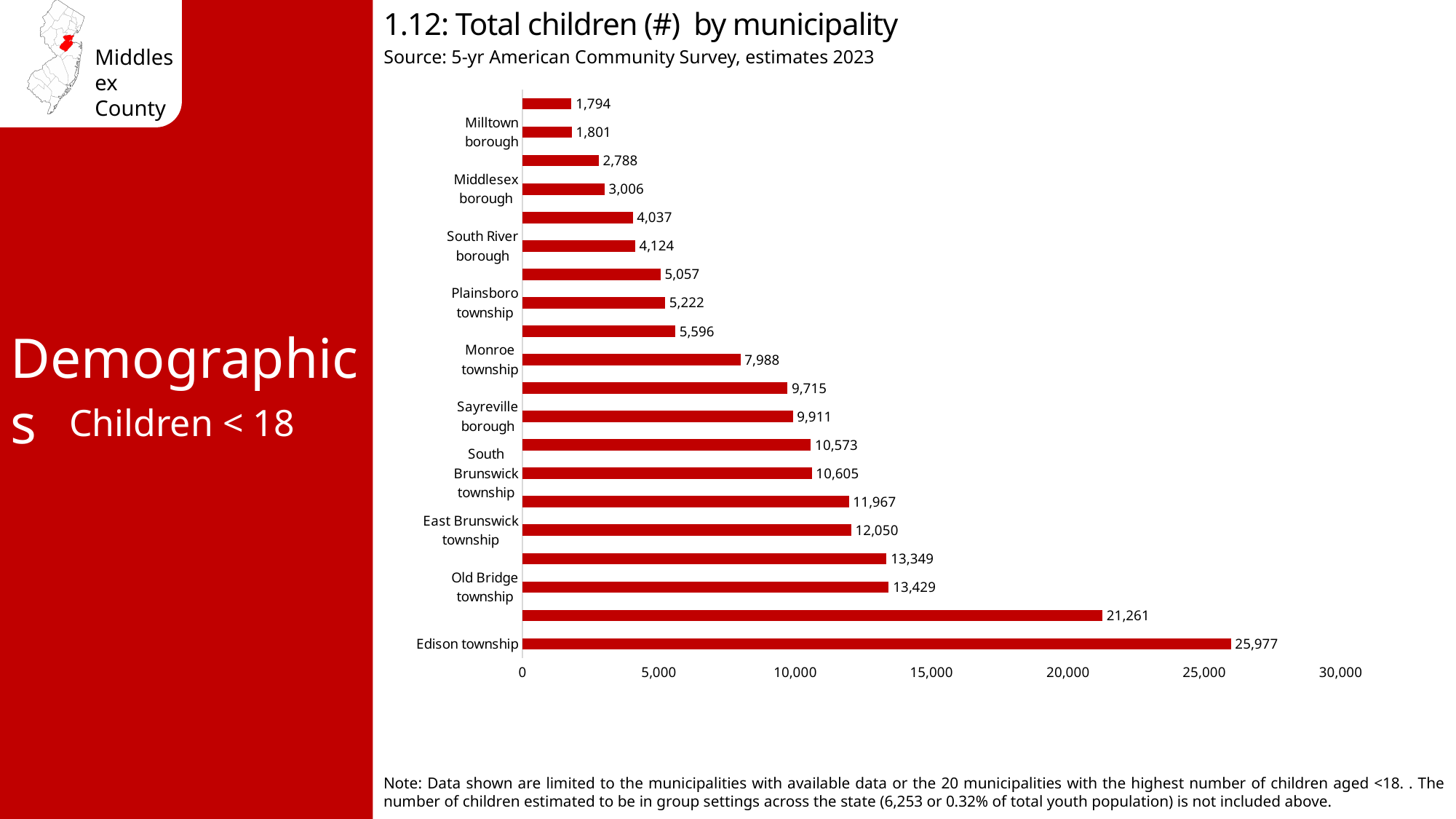
What is the total number of children for Old Bridge township? 13,429 How many municipalities (bars) are plotted in the chart? 20 What type of chart is shown on the slide? bar chart Which municipality has the highest total number of children? Edison township What is the smallest value shown in the chart? 1,794 Is the value for Monroe township greater or less than 10,000? less What is the total number of children for Monroe township? 7,988 What is the total number of children for Milltown borough? 1,801 What is the difference between the values for East Brunswick township and South Brunswick township? 1,445 What is the total number of children for Edison township? 25,977 Which has more children, Sayreville borough or Plainsboro township? Sayreville borough What is the difference between the values for Edison township and Old Bridge township? 12,548